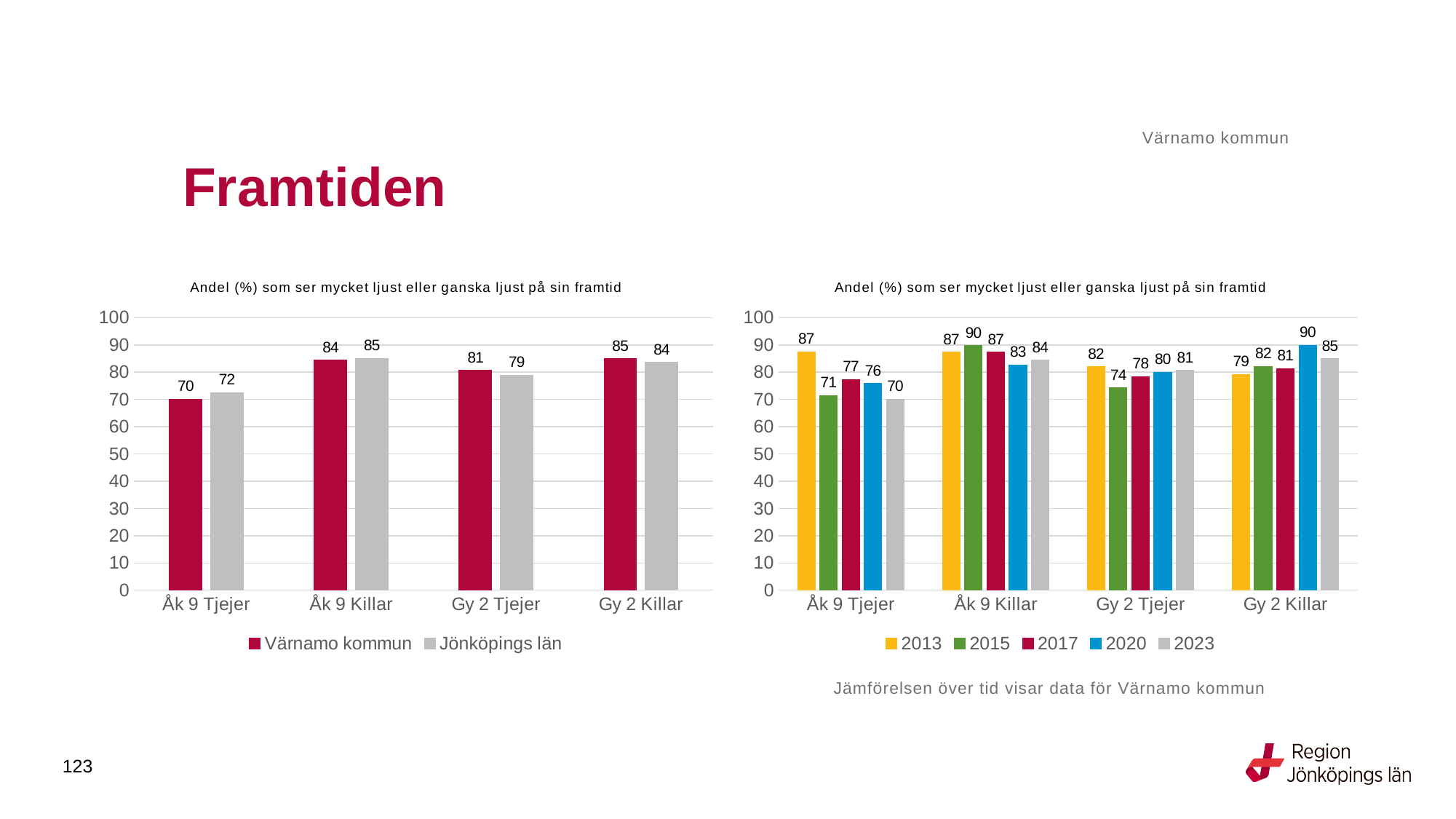
In the left chart, which category has the lowest value for Värnamo kommun? Åk 9 Tjejer In the left chart, what is the difference between Jönköpings län and Värnamo kommun for Åk 9 Tjejer? 2 In the right chart, what is the value for 2020 for Gy 2 Killar? 90 In the right chart, which year has the highest value for Åk 9 Killar? 2015 What kind of chart is the right chart? Bar chart In the right chart, how many series does the legend list? 5 In the right chart, what is the difference between the 2013 and 2023 values for Åk 9 Tjejer? 17 In the left chart, what is the value for Värnamo kommun for Åk 9 Tjejer? 70 In the right chart, which is larger for Gy 2 Tjejer: the 2013 value or the 2015 value? 2013 In the left chart, what is the value for Jönköpings län for Gy 2 Tjejer? 79 In the left chart, how many series does the legend list? 2 In the right chart, what is the value for 2015 for Åk 9 Tjejer? 71